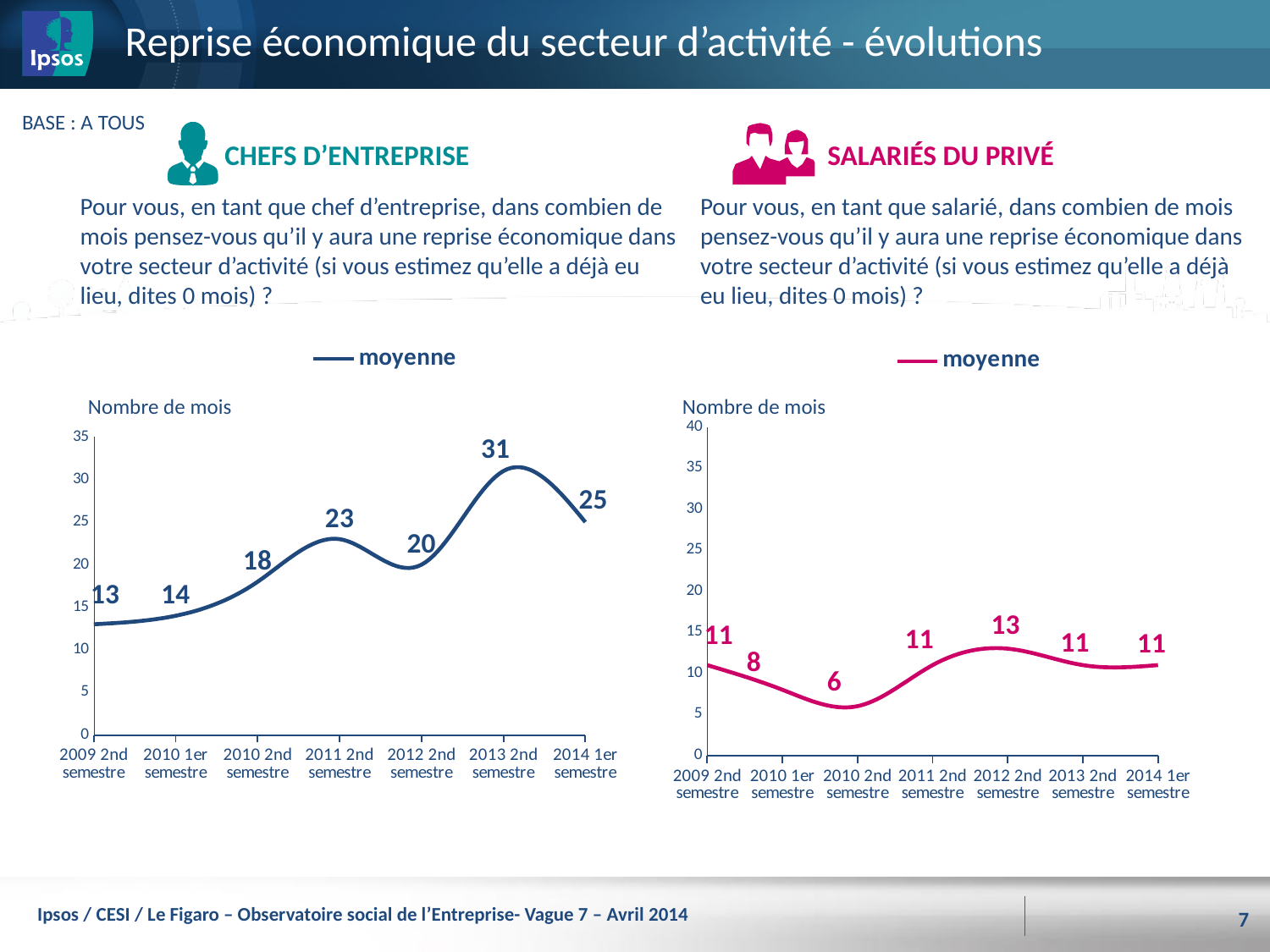
What is the legend entry shown for the SALARIÉS DU PRIVÉ chart? moyenne In the CHEFS D'ENTREPRISE chart, which is larger: the value for 2011 2nd semestre or 2012 2nd semestre? 2011 2nd semestre In the CHEFS D'ENTREPRISE chart, what is the value for 2013 2nd semestre? 31 In the CHEFS D'ENTREPRISE chart, what is the difference between the values for 2013 2nd semestre and 2014 1er semestre? 6 What kind of chart is the SALARIÉS DU PRIVÉ chart? line chart In the SALARIÉS DU PRIVÉ chart, which period has the lowest value? 2010 2nd semestre How many periods are plotted on the x axis of the SALARIÉS DU PRIVÉ chart? 7 In the CHEFS D'ENTREPRISE chart, which period has the highest value? 2013 2nd semestre In the CHEFS D'ENTREPRISE chart, do the values rise or fall from 2009 2nd semestre to 2013 2nd semestre? rise How many series does the legend of the CHEFS D'ENTREPRISE chart list? 1 In the SALARIÉS DU PRIVÉ chart, what is the difference between the values for 2012 2nd semestre and 2010 2nd semestre? 7 In the SALARIÉS DU PRIVÉ chart, what is the value for 2010 2nd semestre? 6